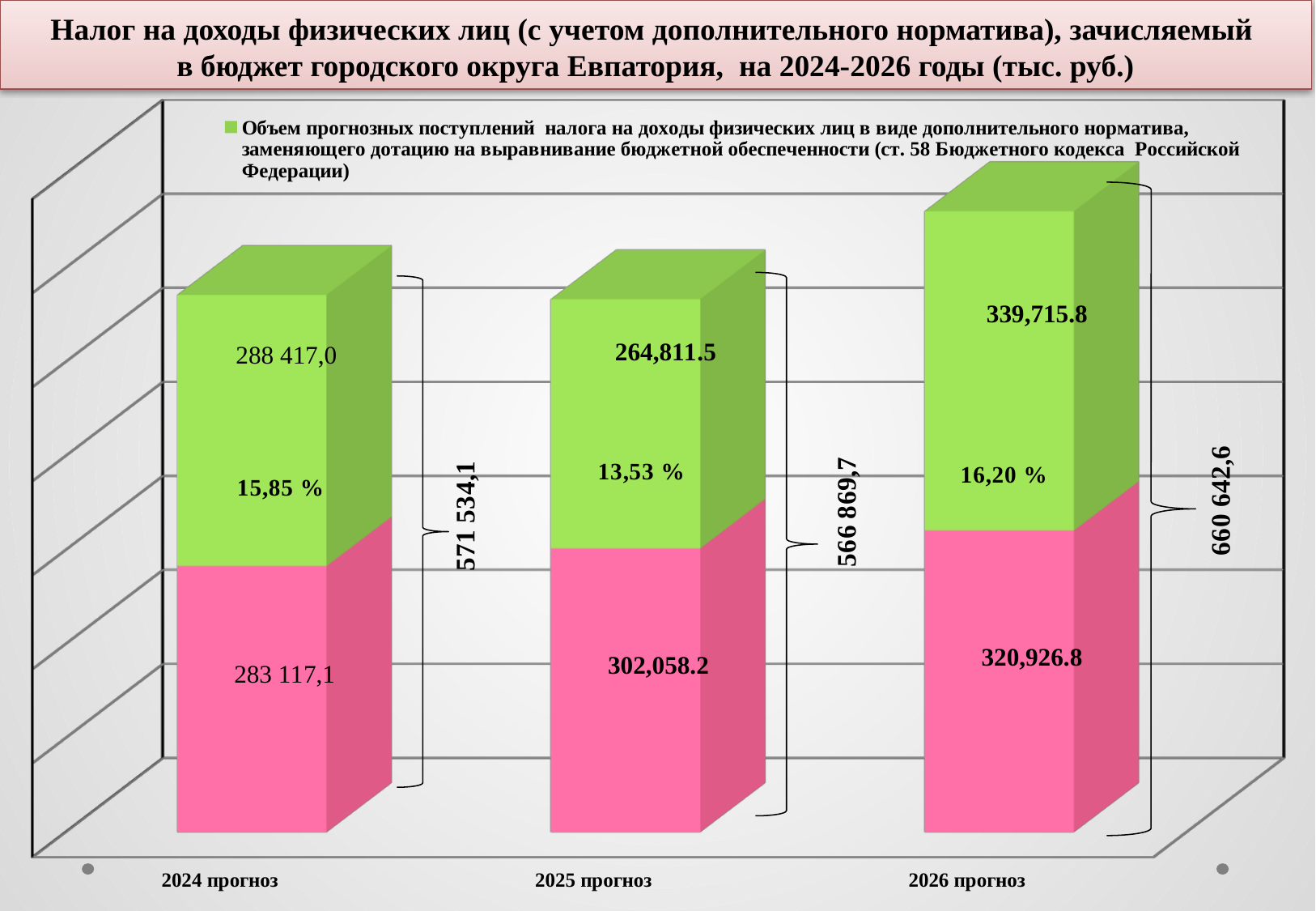
What is the difference between the total for 2026 прогноз and the total for 2024 прогноз? 89 108,5 Which year has the lowest percentage shown on the green segment? 2025 прогноз Which year has the highest total stacked bar value? 2026 прогноз Which is larger: the pink segment for 2024 прогноз or the pink segment for 2025 прогноз? 2025 прогноз What is the difference between the green segment values for 2026 прогноз and 2025 прогноз? 74,904.3 How many categories (years) are shown on the x axis? 3 Which year has the lowest total stacked bar value? 2025 прогноз What is the total of the stacked bar for 2025 прогноз, as shown by the bracket label? 566 869,7 What is the value of the pink (bottom) segment for 2026 прогноз? 320,926.8 What kind of chart is shown on the slide? Stacked bar chart What percentage is shown on the green segment for 2025 прогноз? 13,53 % What is the value of the green (top) segment for 2024 прогноз? 288 417,0